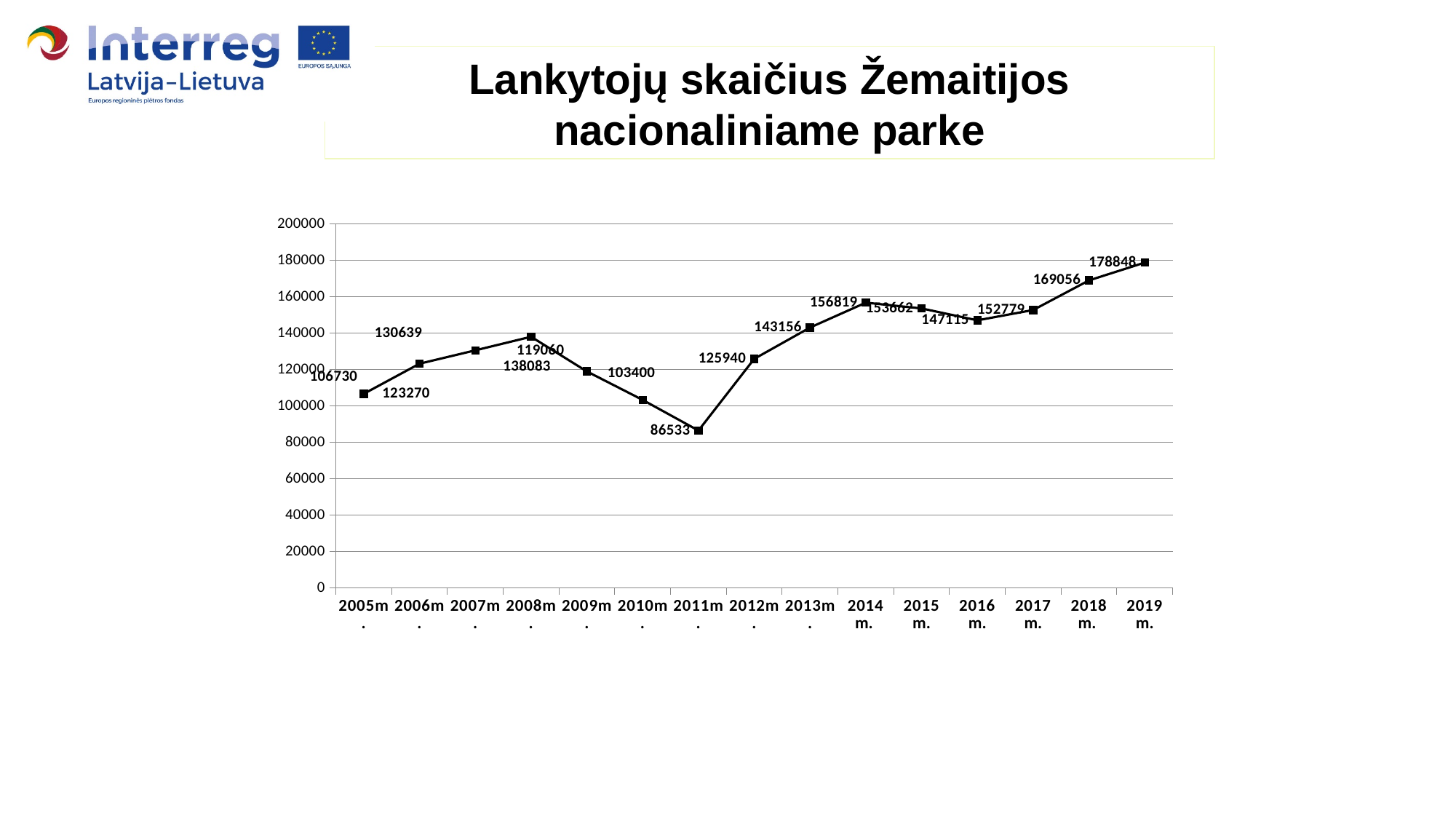
Which year has the lowest number of visitors? 2011 m. What is the title of the chart? Lankytojų skaičius Žemaitijos nacionaliniame parke What is the number of visitors in 2019 m.? 178848 Which year has the highest number of visitors? 2019 m. How many years are plotted on the x axis? 15 What kind of chart is shown on the slide? line chart Do the values rise or fall from 2011 m. to 2014 m.? rise What is the number of visitors in 2011 m.? 86533 What is the difference between the number of visitors in 2019 m. and in 2011 m.? 92315 What is the number of visitors in 2018 m.? 169056 What is the number of visitors in 2013 m.? 143156 Is the value for 2005 m. greater or less than 120000? less